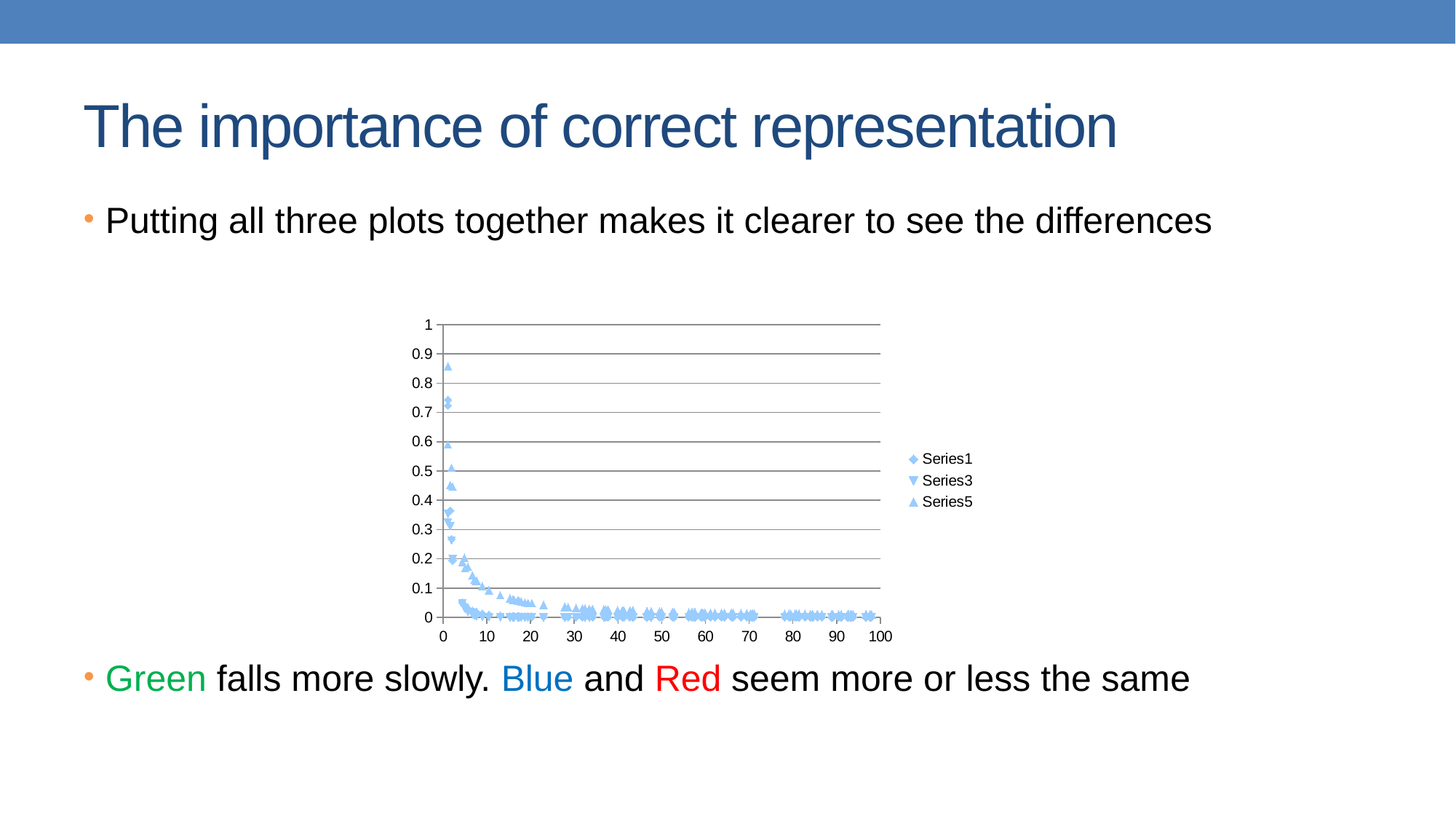
Is the highest plotted point on the chart greater or less than 0.8? greater Are the plotted values at x = 50 greater or less than 0.1? less Which series has the highest plotted value on the chart? Series5 Are the Series5 values around x = 20 greater or less than 0.1? less What are the names of the series listed in the chart's legend? Series1, Series3, Series5 Do the plotted values rise or fall as x increases along the x axis? Fall What is the maximum value shown on the chart's y axis? 1 What kind of chart is shown on the slide? Scatter chart How many series does the chart's legend list? 3